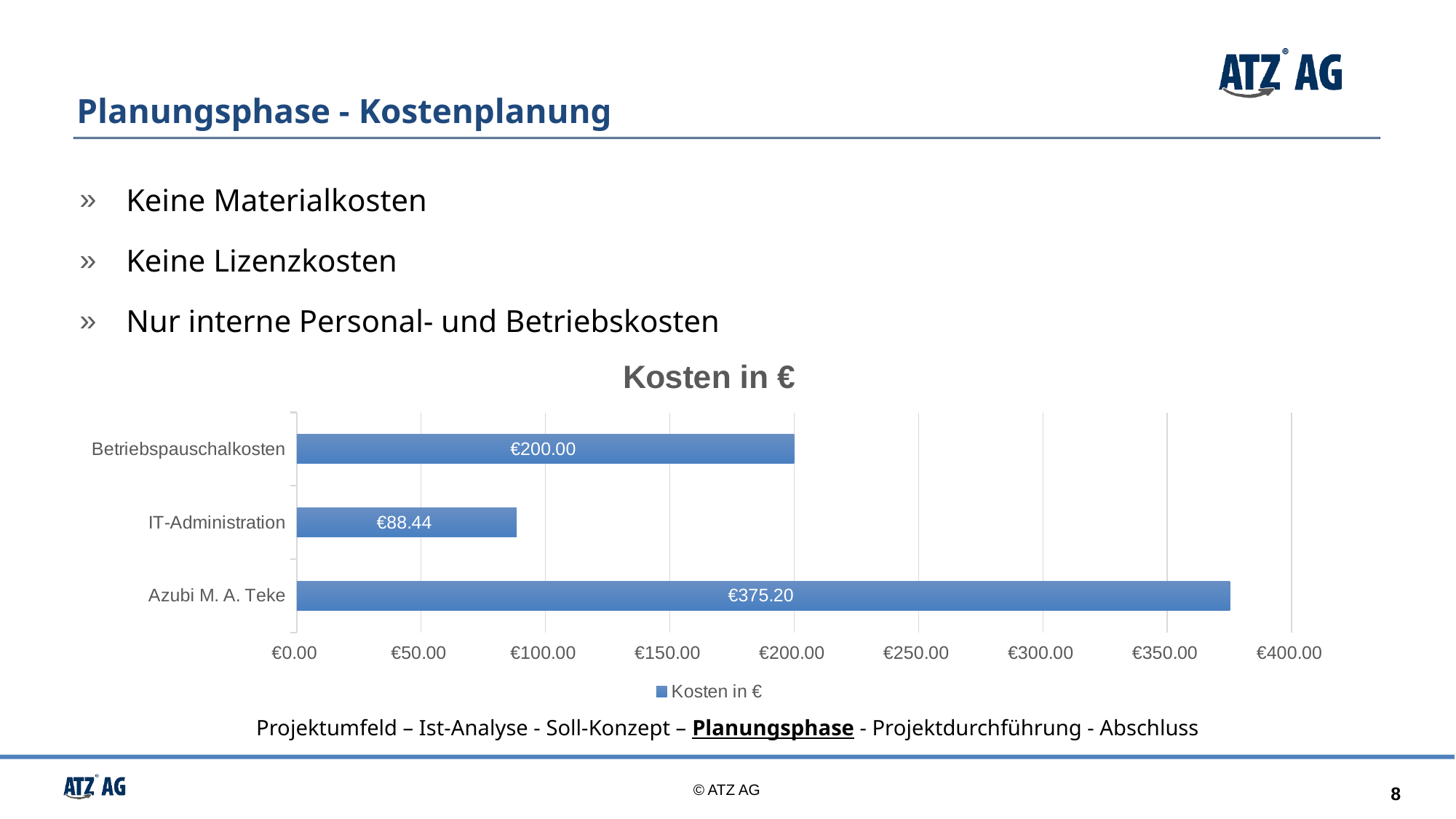
How many categories are shown in the chart? 3 What is the title of the chart? Kosten in € What is the difference between the values for Betriebspauschalkosten and IT-Administration? €111.56 What is the value for IT-Administration? €88.44 What is the difference between the values for Azubi M. A. Teke and Betriebspauschalkosten? €175.20 Which category has the highest cost? Azubi M. A. Teke What is the value for Azubi M. A. Teke? €375.20 Which category has the lowest cost? IT-Administration What kind of chart is shown on the slide? bar chart What is the value for Betriebspauschalkosten? €200.00 Is the value for IT-Administration greater or less than €100.00? less Which is larger, the value for Betriebspauschalkosten or the value for IT-Administration? Betriebspauschalkosten